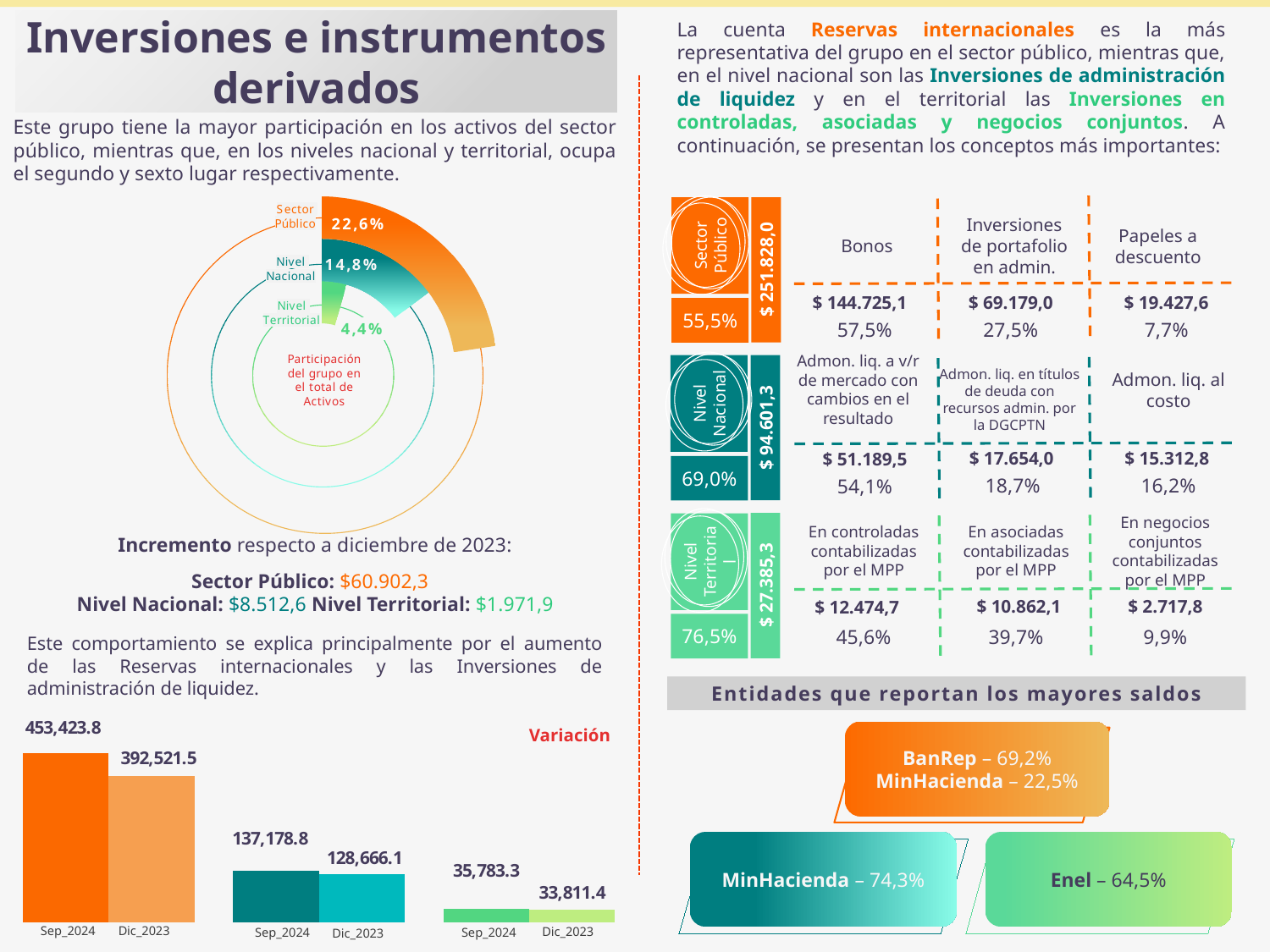
In the bar chart at the bottom left, what is the Sep_2024 value of the first (orange) group? 453,423.8 In the radial chart on the left titled 'Participación del grupo en el total de Activos', what is the value for Sector Público? 22,6% In the radial chart on the left, which category has the highest participation? Sector Público In the bar chart at the bottom left, what is the Dic_2023 value of the third (green) group? 33,811.4 In the radial chart on the left, how many categories are shown? 3 In the bar chart at the bottom left, which is larger for the second (teal) group: Sep_2024 or Dic_2023? Sep_2024 In the radial chart on the left, what is the value for Nivel Territorial? 4,4% In the bar chart at the bottom left, what is the difference between the Sep_2024 and Dic_2023 values of the third (green) group? 1,971.9 In the radial chart on the left, what is the difference between the Sector Público and Nivel Nacional values? 7,8% What kind of chart is shown at the bottom left of the slide? Bar chart In the bar chart at the bottom left, what is the difference between the Sep_2024 and Dic_2023 values of the first (orange) group? 60,902.3 In the radial chart on the left, which category has the lowest participation? Nivel Territorial